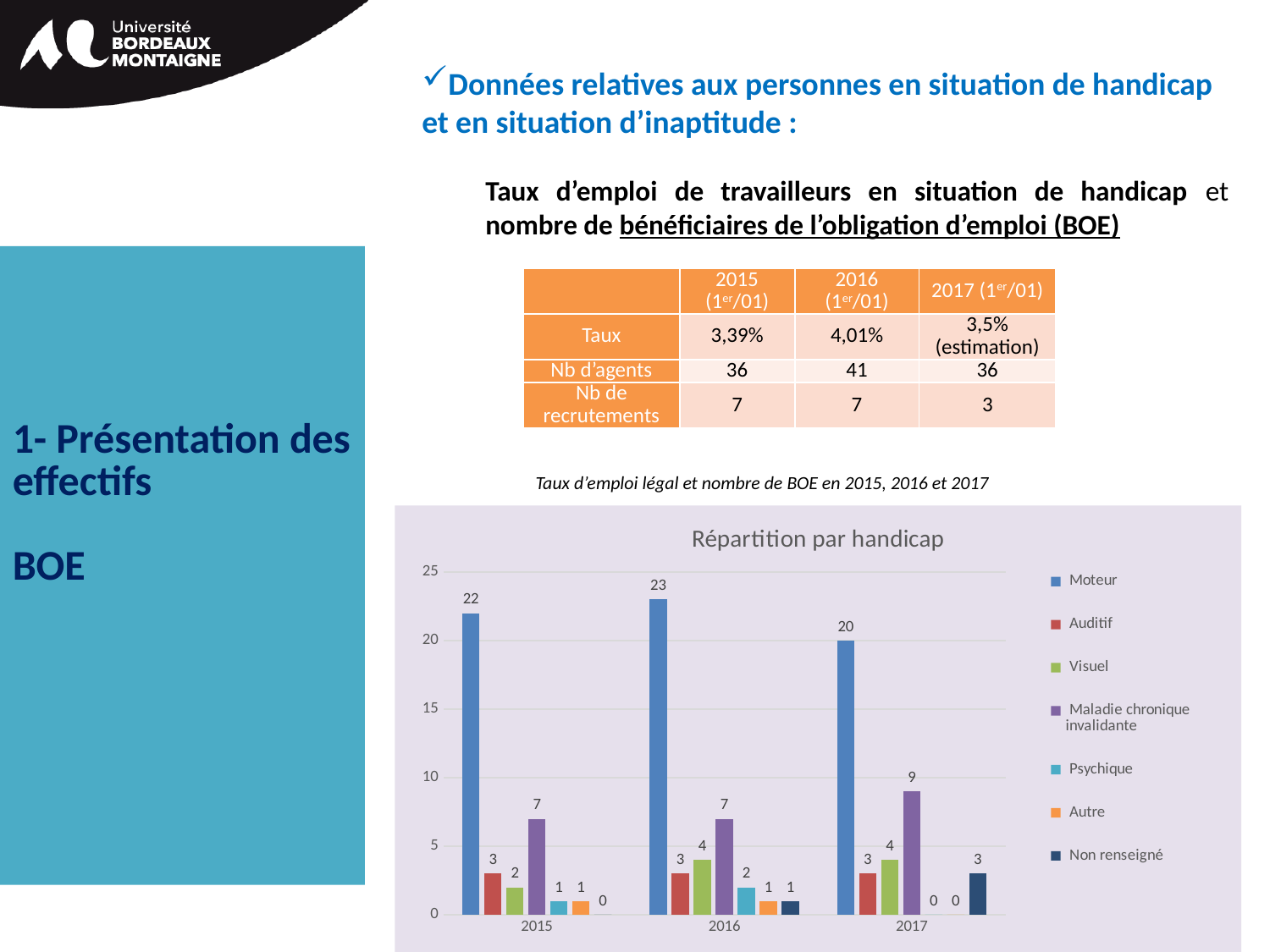
What type of chart is shown on the slide? bar chart Is the value for Moteur in 2015 greater or less than 20? greater How many series does the chart legend list? 7 Which year has the lowest value for Moteur? 2017 What is the difference between the Moteur values in 2016 and 2017? 3 What is the value for Maladie chronique invalidante in 2017? 9 What is the value for Moteur in 2016? 23 What is the title of the chart on the slide? Répartition par handicap How many year categories are shown on the x axis of the chart? 3 Which year has the highest value for Moteur? 2016 What is the value for Non renseigné in 2015? 0 Which is larger in 2017: the value for Visuel or the value for Non renseigné? Visuel